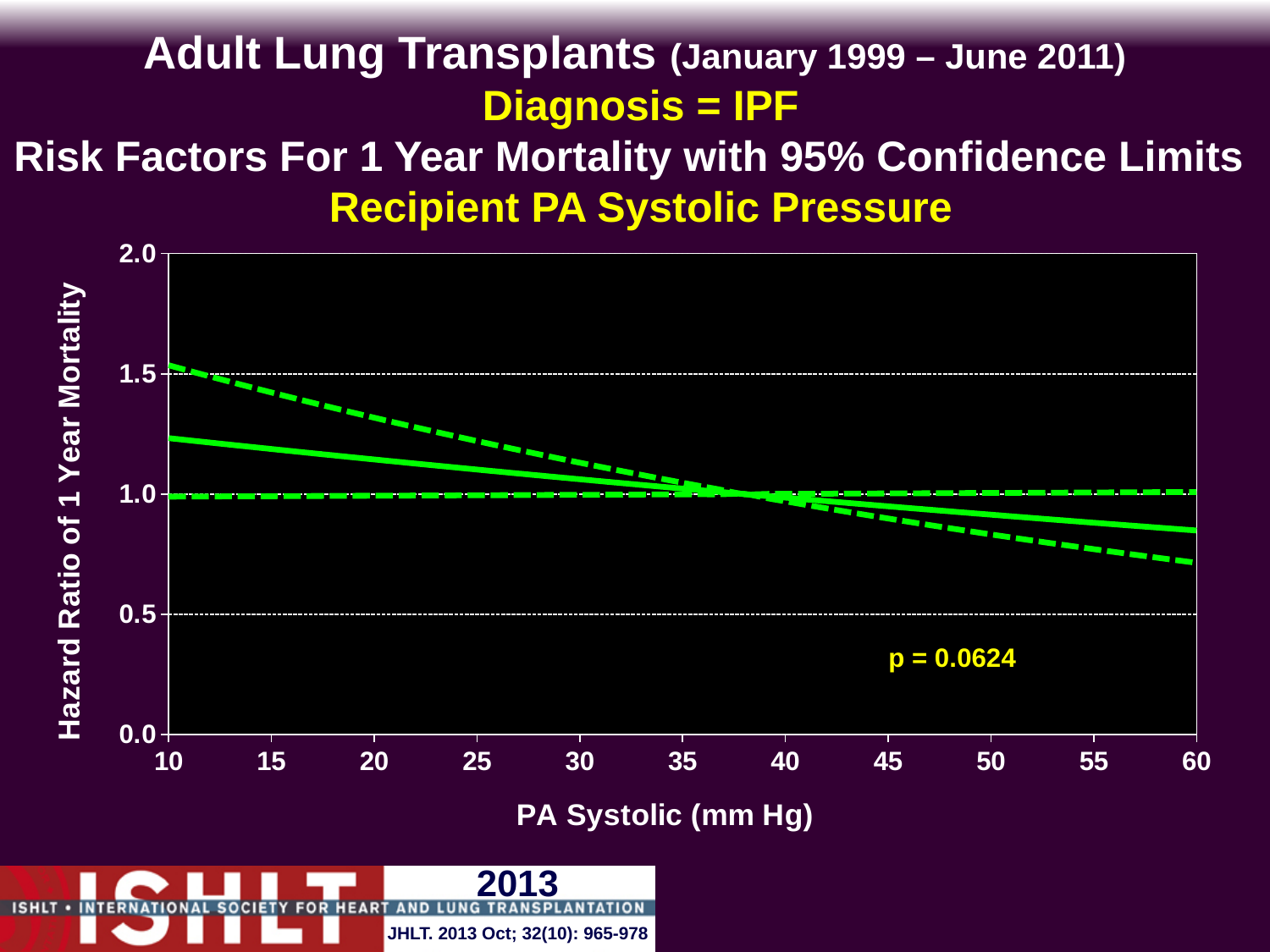
Is the upper 95% confidence limit at a PA systolic pressure of 10 mm Hg greater or less than 1.0? greater Is the hazard ratio (solid line) at a PA systolic pressure of 10 mm Hg greater or less than 1.5? less What is the maximum value shown on the y axis? 2.0 Is the hazard ratio (solid line) higher at a PA systolic pressure of 10 mm Hg or at 60 mm Hg? 10 mm Hg Is the lower 95% confidence limit at a PA systolic pressure of 60 mm Hg greater or less than 0.5? greater What kind of chart is shown on the slide? Line chart What is the p-value printed on the chart? p = 0.0624 How many lines are plotted on the chart? 3 What is the label of the x axis? PA Systolic (mm Hg) Does the solid hazard ratio line rise or fall as PA systolic pressure increases from 10 to 60 mm Hg? Fall